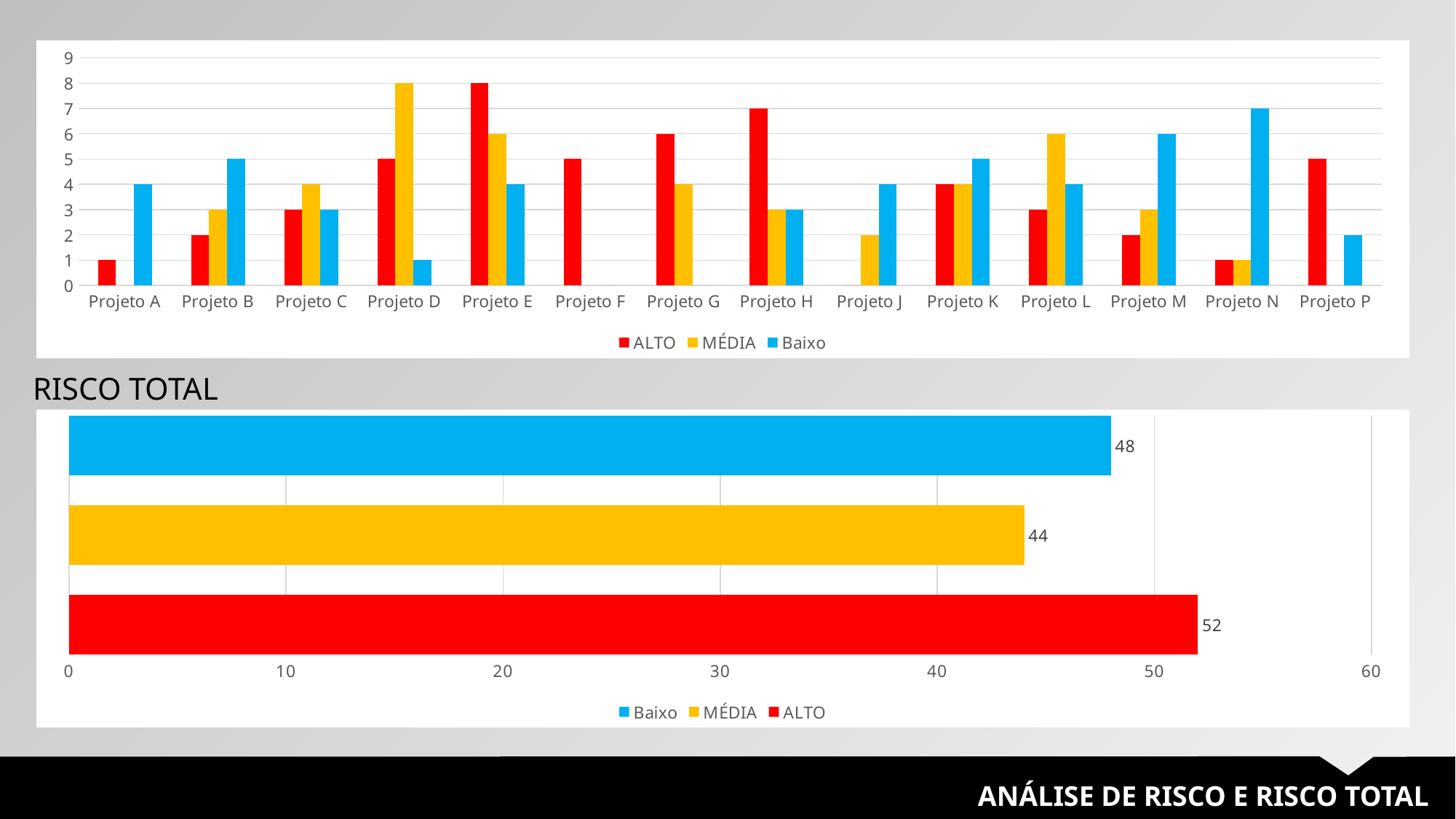
In the top chart, what is the Baixo value for Projeto N? 7 In the bottom chart titled RISCO TOTAL, what kind of chart is shown? Bar chart In the bottom chart titled RISCO TOTAL, which series has the highest value? ALTO In the top chart, how many series does the legend list? 3 In the bottom chart titled RISCO TOTAL, which series has the lowest value? MÉDIA In the top chart, which is larger for Projeto D: the MÉDIA value or the Baixo value? MÉDIA In the bottom chart titled RISCO TOTAL, what is the value for ALTO? 52 In the bottom chart titled RISCO TOTAL, what is the difference between the ALTO value and the MÉDIA value? 8 In the top chart, what is the ALTO value for Projeto E? 8 In the top chart, how many projects are shown on the x axis? 14 In the top chart, which project has the highest ALTO value? Projeto E In the bottom chart titled RISCO TOTAL, what is the value for Baixo? 48